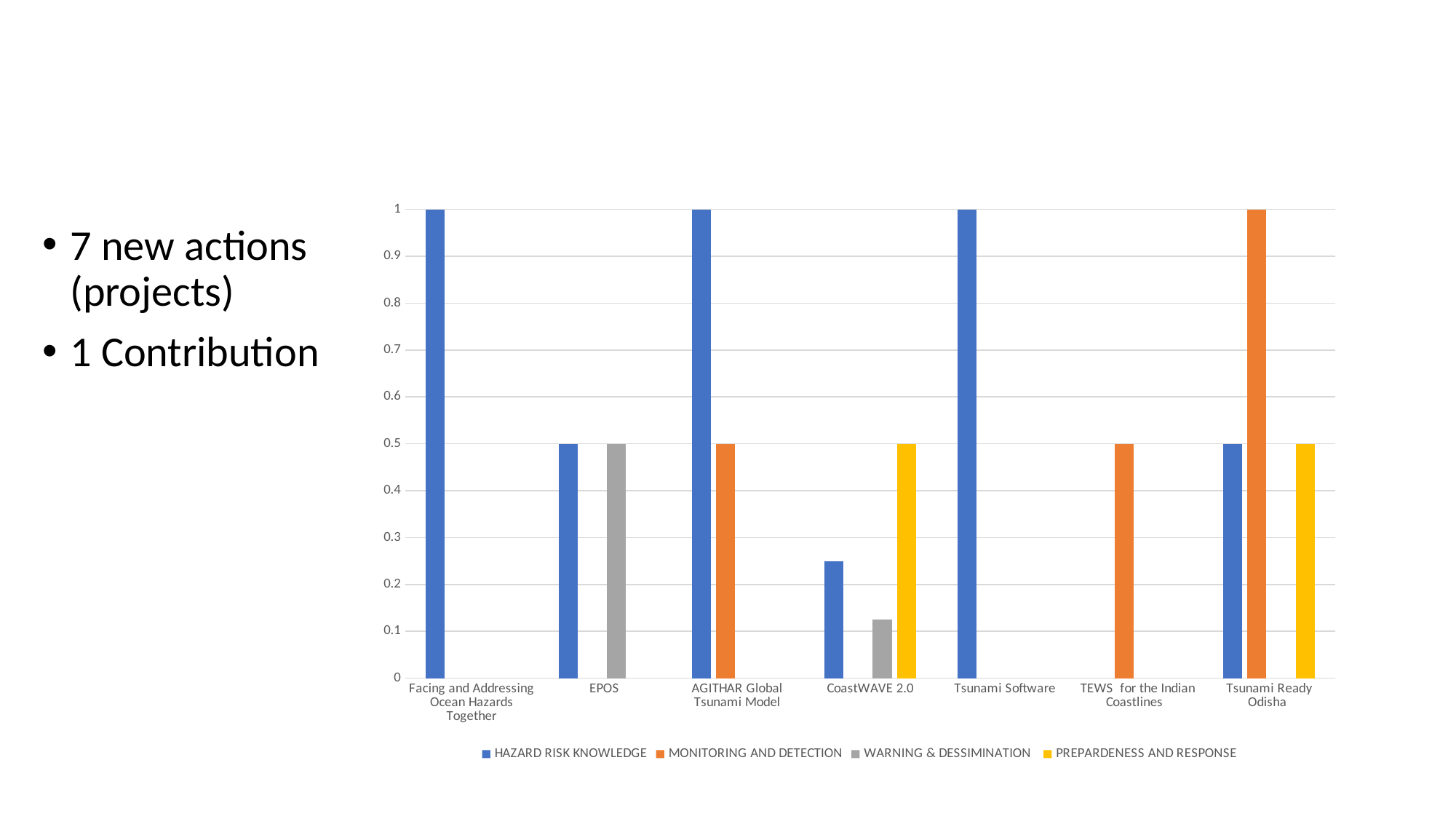
What is the MONITORING AND DETECTION value for Tsunami Ready Odisha? 1 Which series is shown in orange in the legend? MONITORING AND DETECTION Is the WARNING & DESSIMINATION value for CoastWAVE 2.0 greater or less than 0.2? less Is the HAZARD RISK KNOWLEDGE value for CoastWAVE 2.0 greater or less than 0.5? less What is the difference between the HAZARD RISK KNOWLEDGE value for Tsunami Software and for Tsunami Ready Odisha? 0.5 What kind of chart is shown on the slide? bar chart What is the HAZARD RISK KNOWLEDGE value for Tsunami Software? 1 Which is larger: the HAZARD RISK KNOWLEDGE value for AGITHAR Global Tsunami Model or for EPOS? AGITHAR Global Tsunami Model What is the HAZARD RISK KNOWLEDGE value for EPOS? 0.5 How many categories are shown on the x axis? 7 How many series does the legend list? 4 What is the WARNING & DESSIMINATION value for EPOS? 0.5